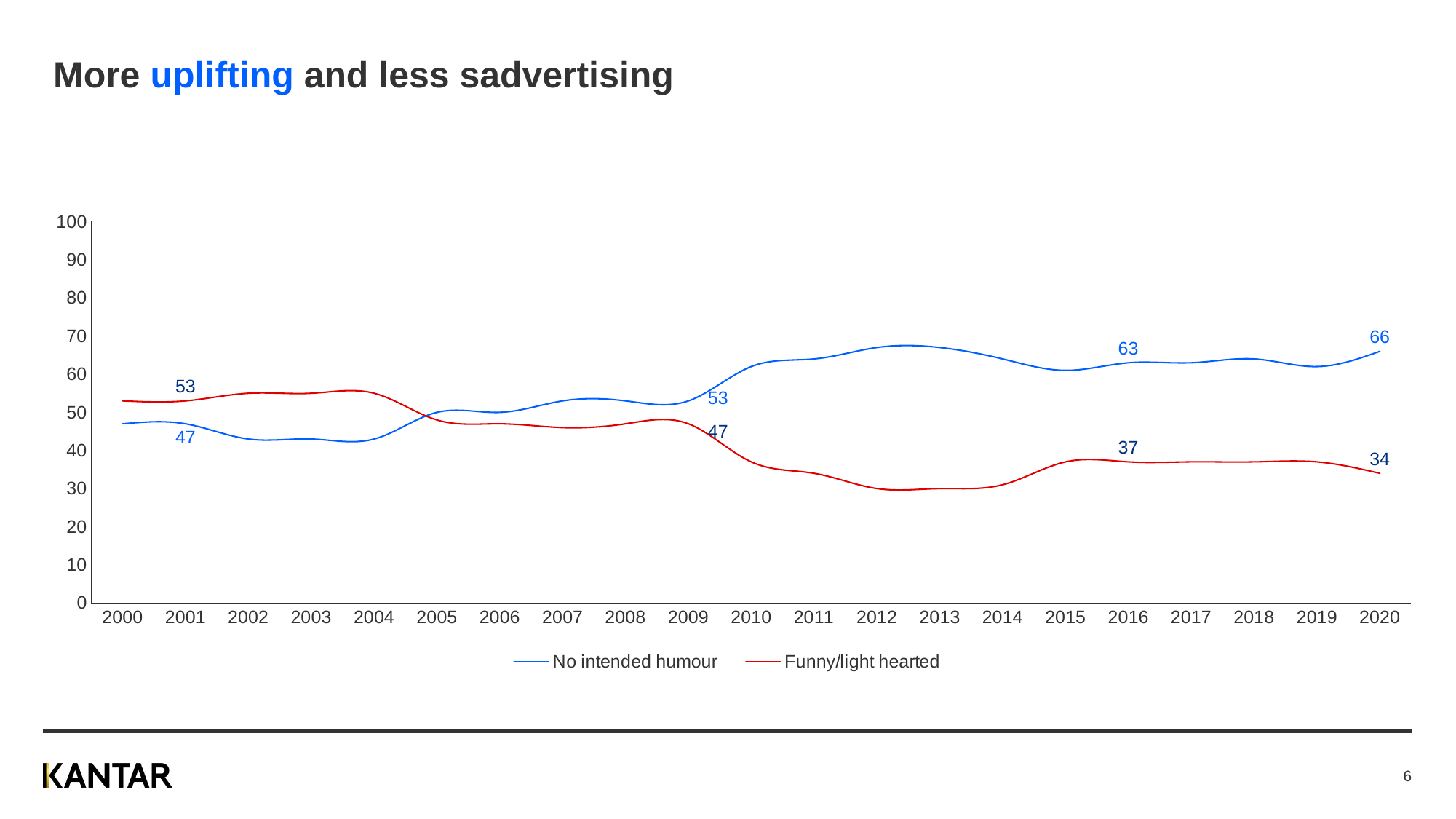
What is the value for No intended humour in 2020? 66 Is the value for Funny/light hearted in 2013 greater or less than 40? less What type of chart is shown on the slide? line chart How many series does the legend list? 2 How many years are shown on the x axis? 21 Which series has the higher value in 2001, No intended humour or Funny/light hearted? Funny/light hearted What is the value for No intended humour in 2016? 63 What is the value for Funny/light hearted in 2020? 34 What is the difference between No intended humour and Funny/light hearted in 2016? 26 What is the value for Funny/light hearted in 2001? 53 What is the difference between No intended humour and Funny/light hearted in 2020? 32 Does the Funny/light hearted series rise or fall overall from 2000 to 2020? fall